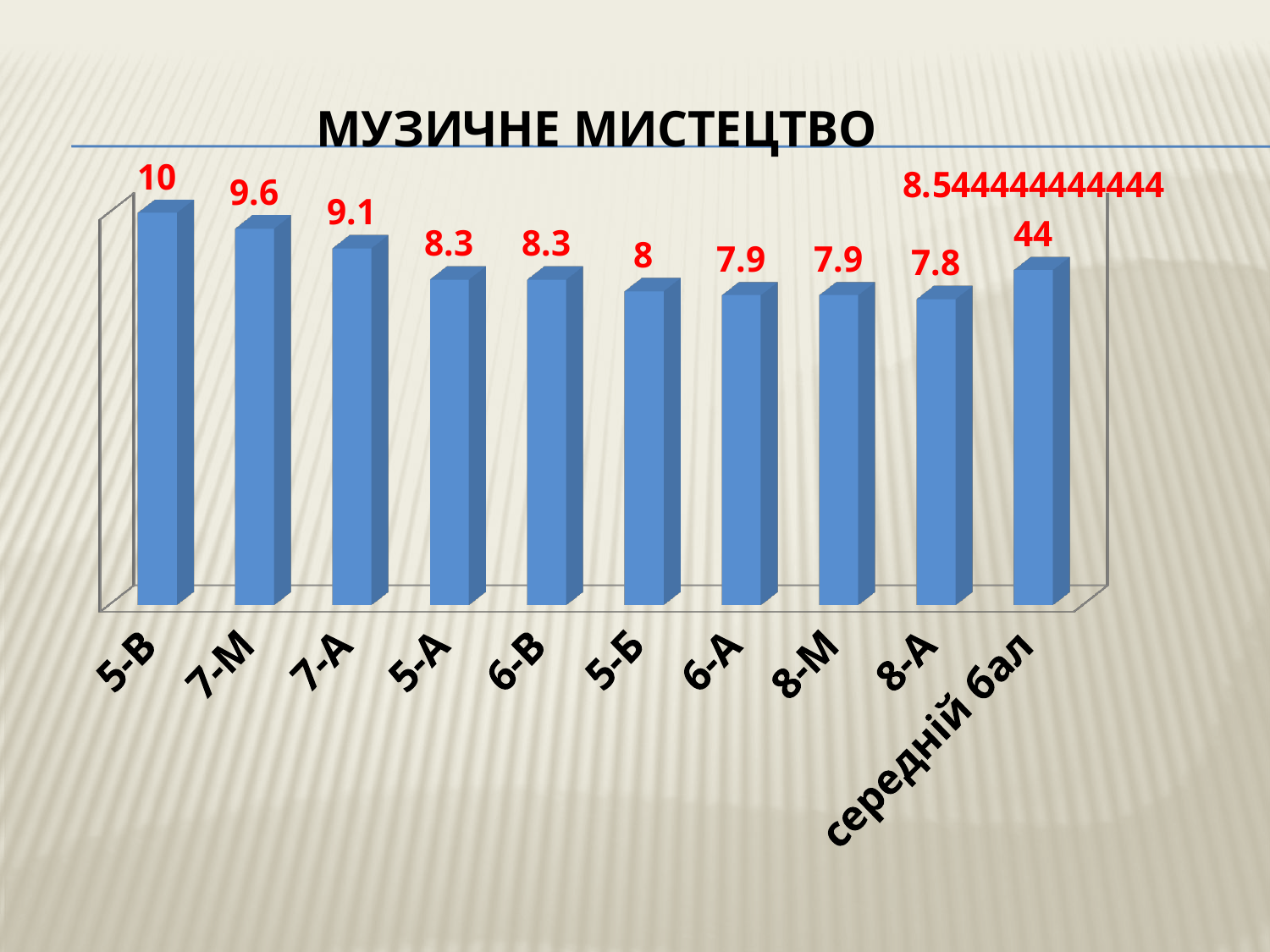
What is the title of the chart? МУЗИЧНЕ МИСТЕЦТВО What kind of chart is shown on the slide? bar chart Which is larger, the value for 7-А or the value for 5-А? 7-А What is the difference between the values for 5-В and 8-А? 2.2 What is the value for 5-Б? 8 What is the value for 5-В? 10 Which category has the highest value? 5-В What is the difference between the values for 7-М and 7-А? 0.5 Which category has the lowest value? 8-А What is the value for 7-М? 9.6 What is the value for 8-А? 7.8 How many categories are shown on the x axis? 10